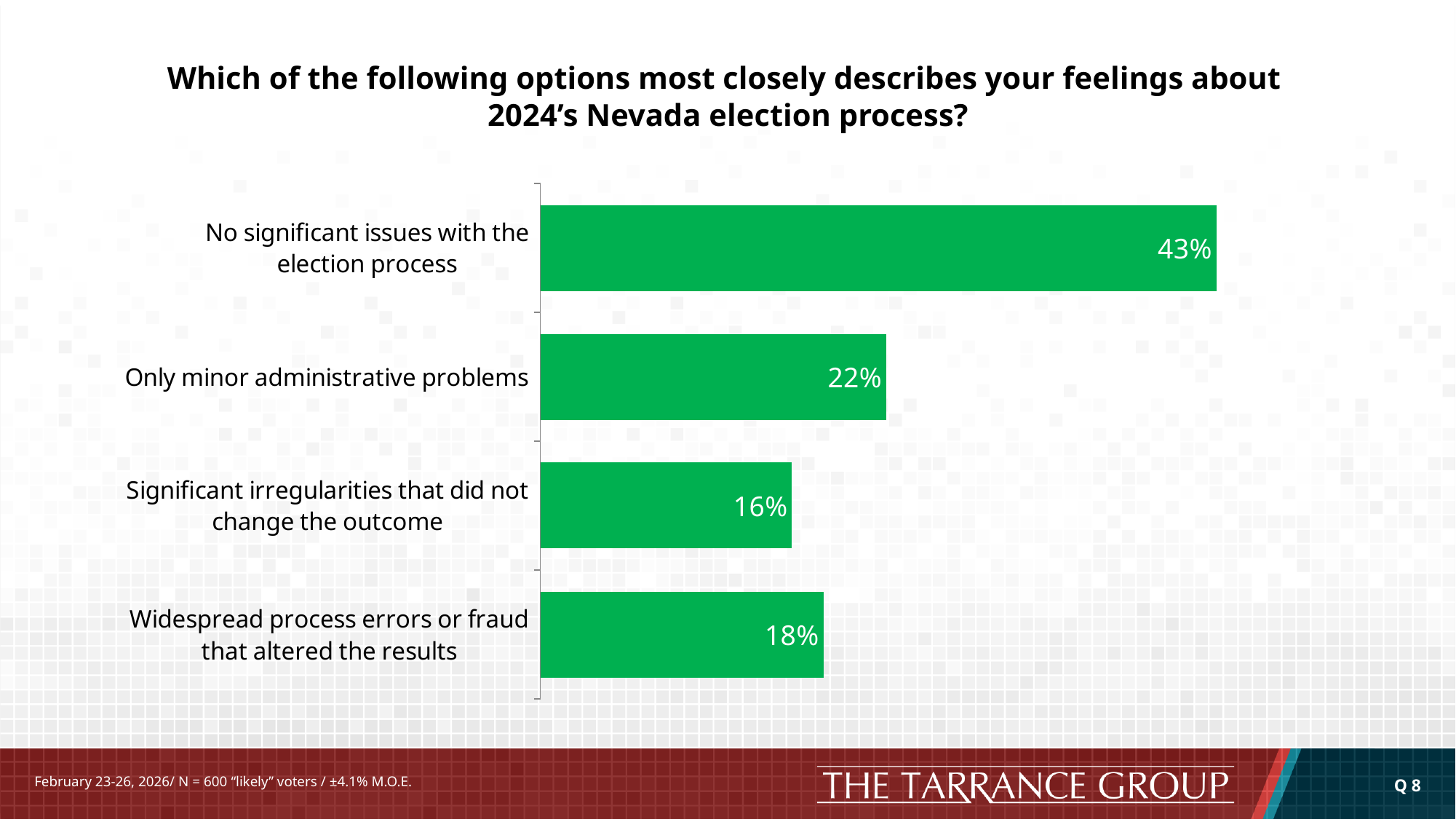
How many response options are shown in the chart? 4 Which option has the highest percentage? No significant issues with the election process What colour are the bars in the chart? Green What is the difference between "Widespread process errors or fraud that altered the results" and "Significant irregularities that did not change the outcome"? 2 percentage points What is the value for "Only minor administrative problems"? 22% What percentage of respondents said there were no significant issues with the election process? 43% Which option has the lowest percentage? Significant irregularities that did not change the outcome What type of chart is shown on the slide? Bar chart What is the value for "Widespread process errors or fraud that altered the results"? 18% Which is larger: the value for "Only minor administrative problems" or for "Widespread process errors or fraud that altered the results"? Only minor administrative problems What is the difference between the percentage for "No significant issues with the election process" and "Only minor administrative problems"? 21 percentage points What percentage chose "Significant irregularities that did not change the outcome"? 16%